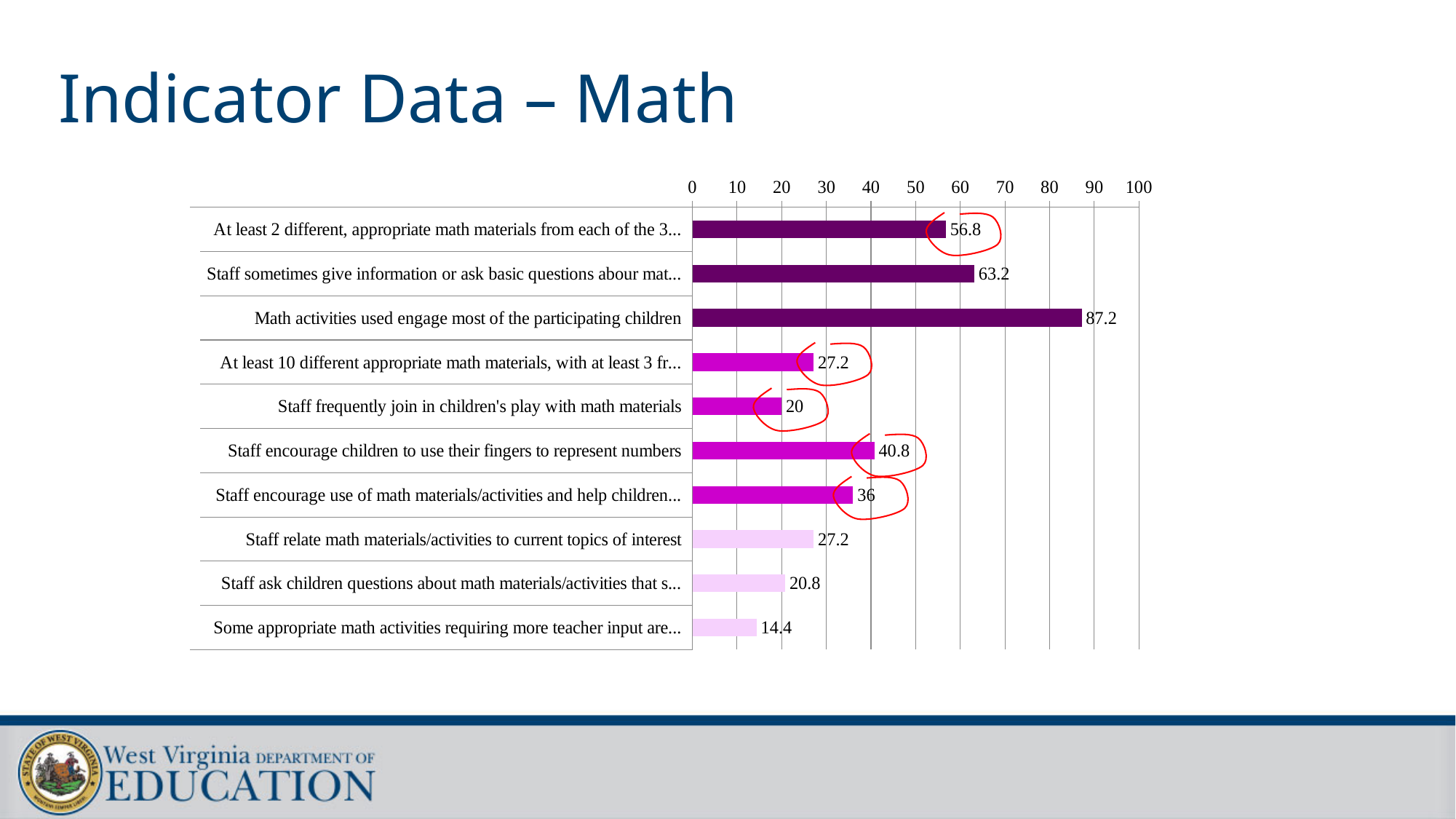
How many categories are shown in the chart? 10 What is the value for "Staff ask children questions about math materials/activities that s..."? 20.8 What is the value for "Staff encourage children to use their fingers to represent numbers"? 40.8 Which is larger: the value for "Staff sometimes give information or ask basic questions abour mat..." or the value for "At least 2 different, appropriate math materials from each of the 3..."? Staff sometimes give information or ask basic questions abour mat... Which category has the highest value? Math activities used engage most of the participating children What kind of chart is shown on the slide? Bar chart What is the difference between the values for "Math activities used engage most of the participating children" and "Staff sometimes give information or ask basic questions abour mat..."? 24 What is the value for "Math activities used engage most of the participating children"? 87.2 Which category has the lowest value? Some appropriate math activities requiring more teacher input are... Is the value for "At least 2 different, appropriate math materials from each of the 3..." greater or less than 50? greater What is the value for "Staff frequently join in children's play with math materials"? 20 What is the difference between the values for "Staff encourage children to use their fingers to represent numbers" and "Staff encourage use of math materials/activities and help children..."? 4.8